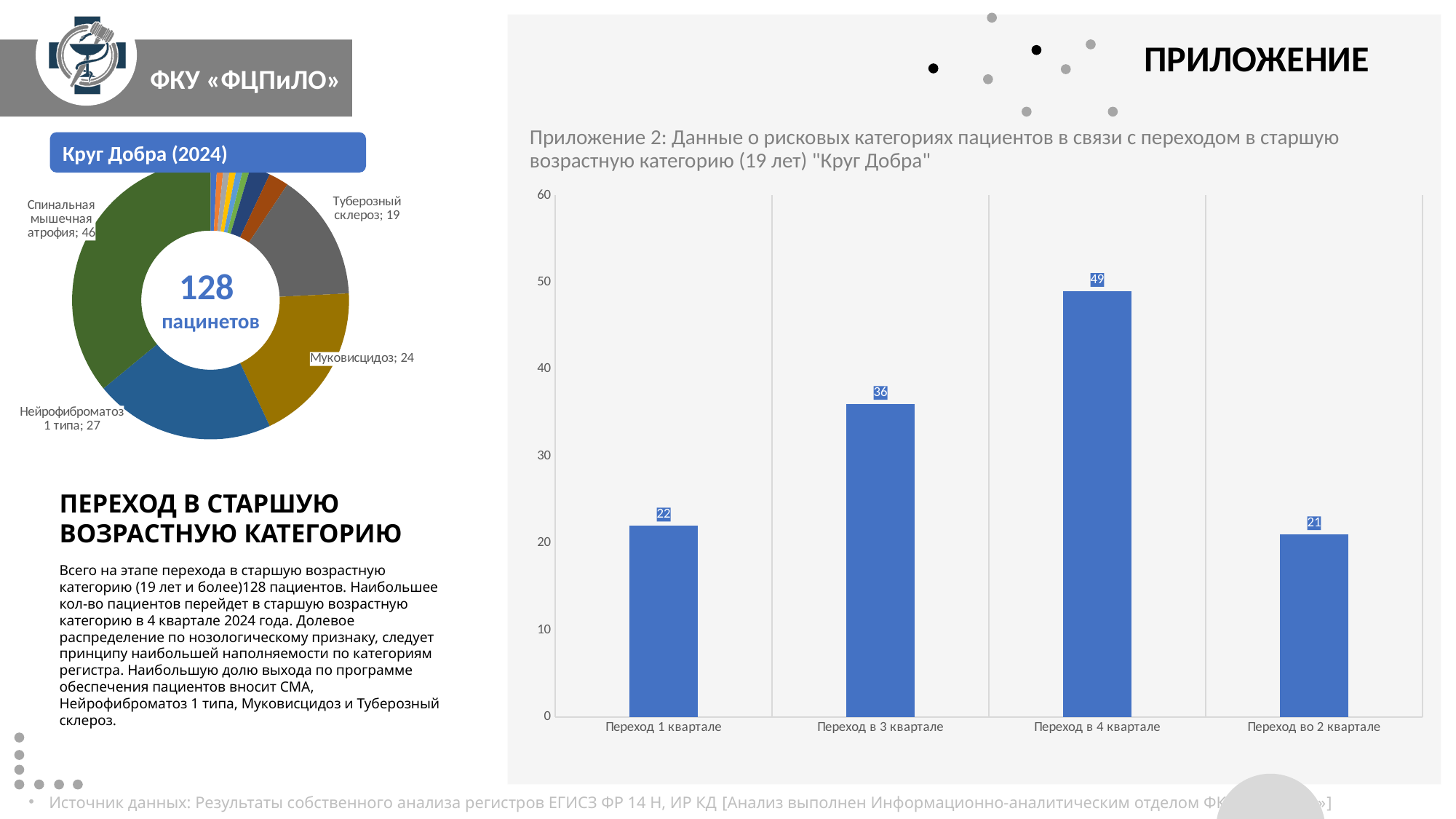
In the bar chart on the right, what is the difference between the values for "Переход в 4 квартале" and "Переход 1 квартале"? 27 What kind of chart is the chart on the right of the slide? Bar chart In the bar chart on the right, which category has the highest value? Переход в 4 квартале In the donut chart "Круг Добра (2024)", what is the value for "Муковисцидоз"? 24 In the bar chart on the right, which is larger: the value for "Переход в 3 квартале" or "Переход 1 квартале"? Переход в 3 квартале In the bar chart on the right, what is the value for "Переход в 3 квартале"? 36 In the bar chart on the right, how many categories are shown on the x axis? 4 In the donut chart "Круг Добра (2024)", which is larger: "Нейрофиброматоз 1 типа" or "Туберозный склероз"? Нейрофиброматоз 1 типа What total number of patients is shown in the centre of the donut chart "Круг Добра (2024)"? 128 In the bar chart on the right, which category has the lowest value? Переход во 2 квартале In the bar chart on the right, what is the value for "Переход в 4 квартале"? 49 In the donut chart "Круг Добра (2024)", what is the value for "Спинальная мышечная атрофия"? 46